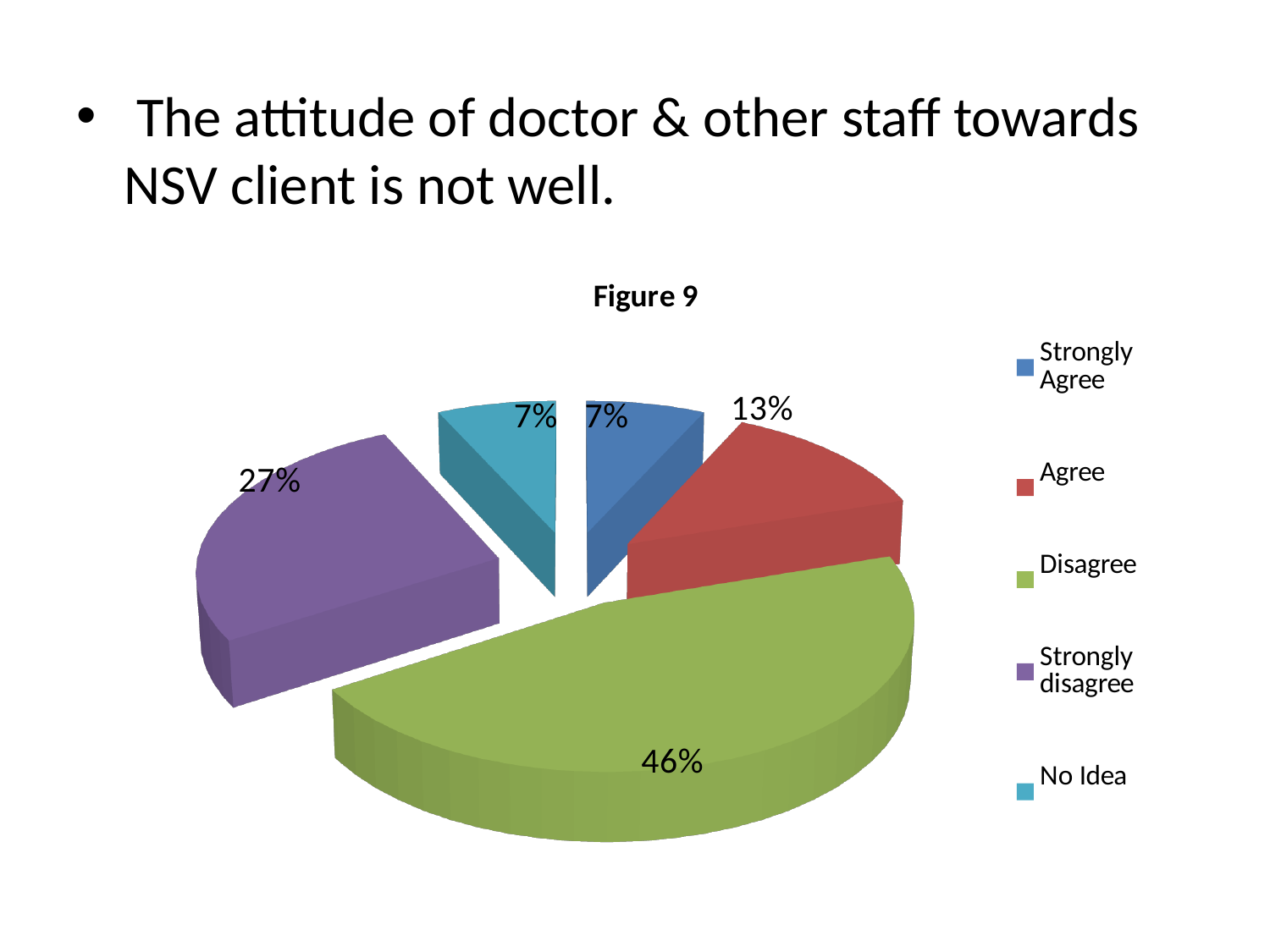
Which is larger, the Agree slice or the Strongly disagree slice? Strongly disagree What share of the pie is labelled Strongly Agree? 7% What share of the pie is labelled No Idea? 7% What share of the pie is labelled Agree? 13% What is the chart's title? Figure 9 What kind of chart is shown on the slide? pie chart How many categories does the legend list? 5 What is the difference between the Disagree share and the Strongly disagree share? 19% What colour is the Disagree slice? green Which category has the largest slice of the pie? Disagree